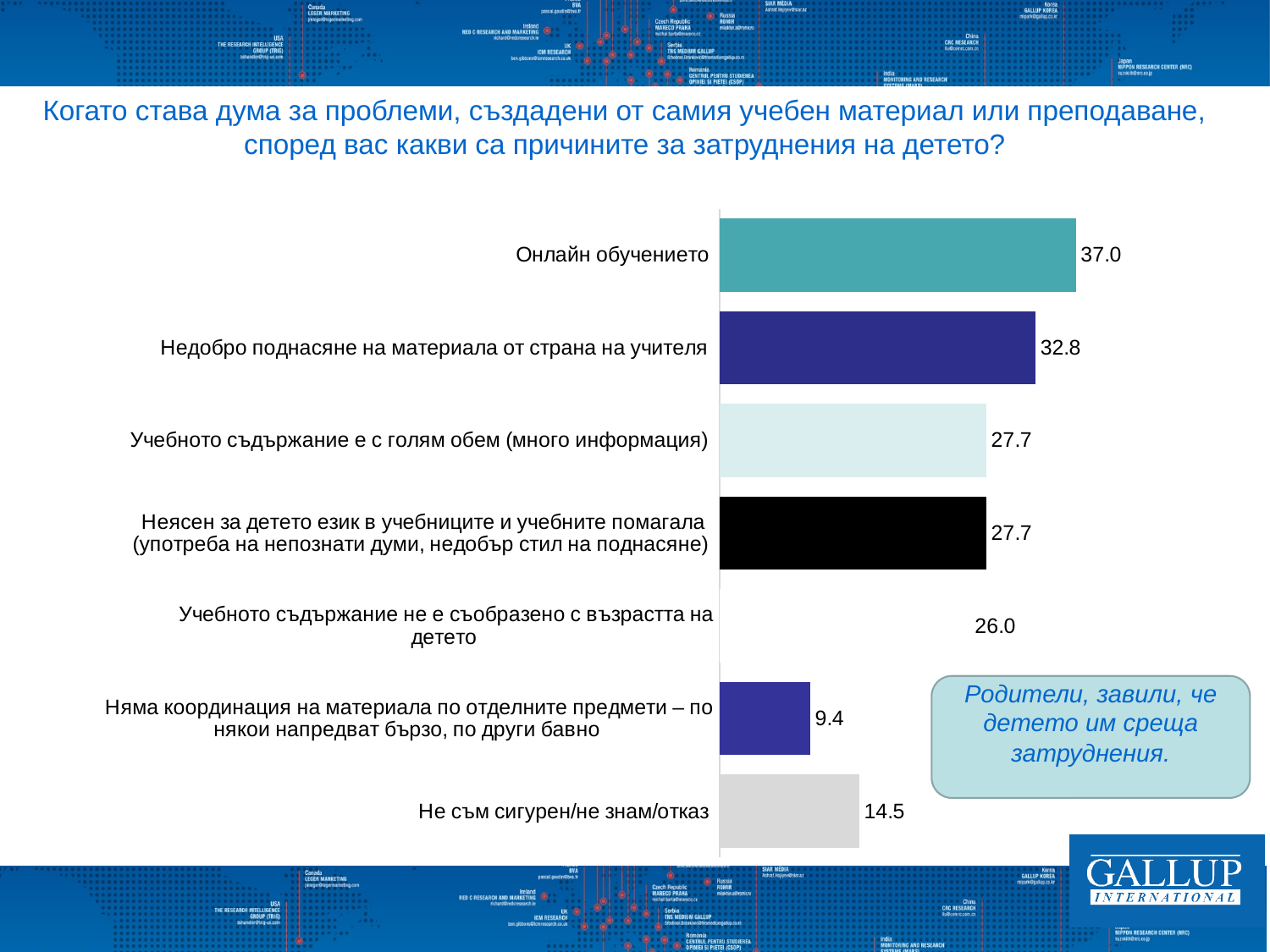
What is the value for "Няма координация на материала по отделните предмети – по някои напредват бързо, по други бавно"? 9.4 Which category has the highest value? Онлайн обучението Which is larger: the value for "Не съм сигурен/не знам/отказ" or the value for "Няма координация на материала по отделните предмети – по някои напредват бързо, по други бавно"? Не съм сигурен/не знам/отказ What is the value for "Не съм сигурен/не знам/отказ"? 14.5 What kind of chart is shown on the slide? Bar chart What is the value for "Недобро поднасяне на материала от страна на учителя"? 32.8 What is the value for "Учебното съдържание не е съобразено с възрастта на детето"? 26.0 Which category has the lowest value? Няма координация на материала по отделните предмети – по някои напредват бързо, по други бавно What is the value for "Онлайн обучението"? 37.0 How many categories are shown in the chart? 7 What is the difference between the values for "Онлайн обучението" and "Недобро поднасяне на материала от страна на учителя"? 4.2 What does the text box on the chart say? Родители, завили, че детето им среща затруднения.